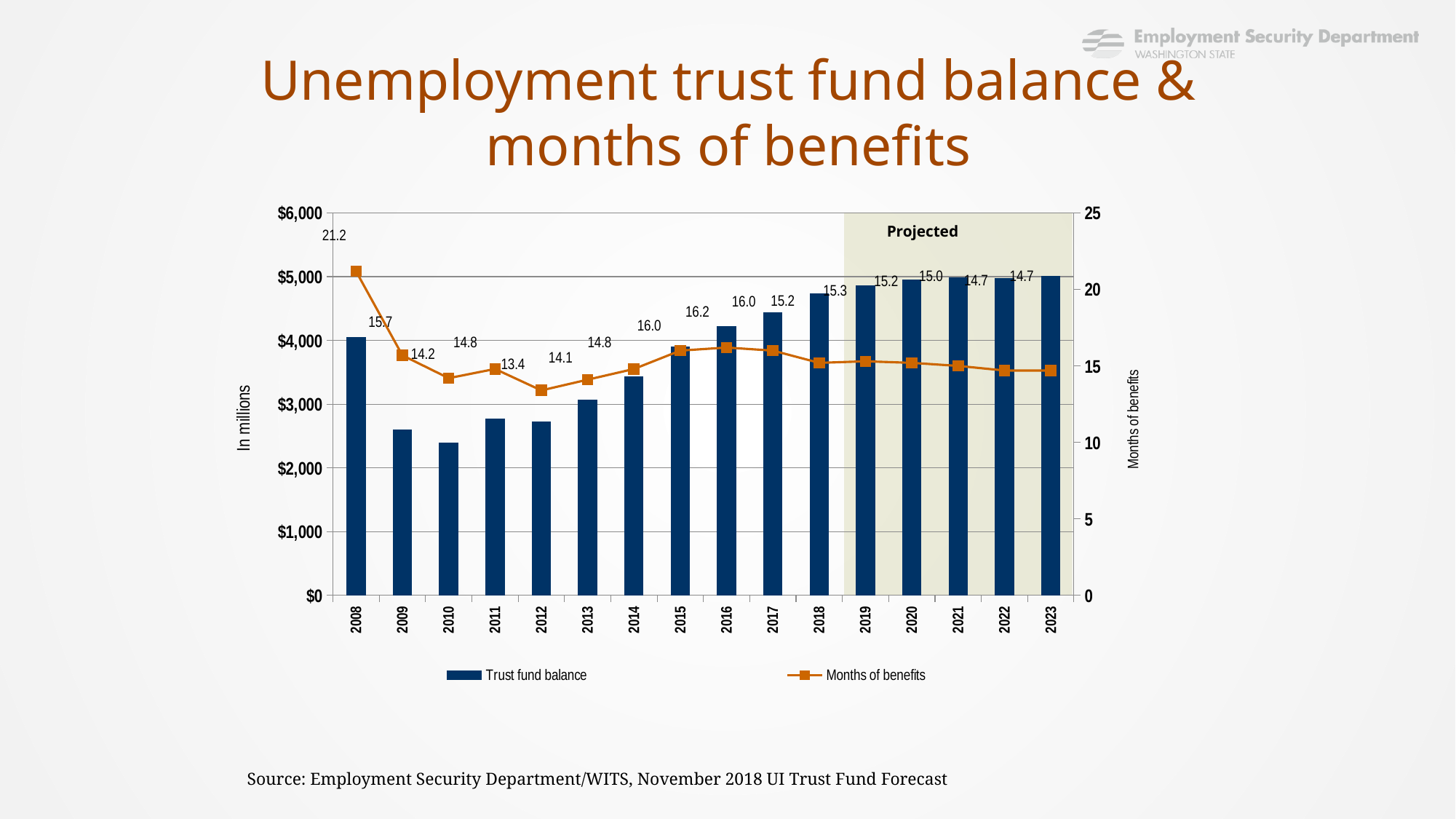
Which year has the lowest months of benefits value? 2012 How many years are shown on the x axis? 16 Which year has the highest months of benefits value? 2008 What is the months of benefits value for 2012? 13.4 Is the trust fund balance for 2010 greater or less than $3,000? less What is the difference between the months of benefits values for 2008 and 2009? 5.5 How many series does the legend list? 2 What label is shown over the shaded area covering 2019 to 2023? Projected What is the months of benefits value for 2008? 21.2 What is the months of benefits value for 2023? 14.7 Is the trust fund balance for 2018 greater or less than $4,000? greater What is the months of benefits value for 2016? 16.2